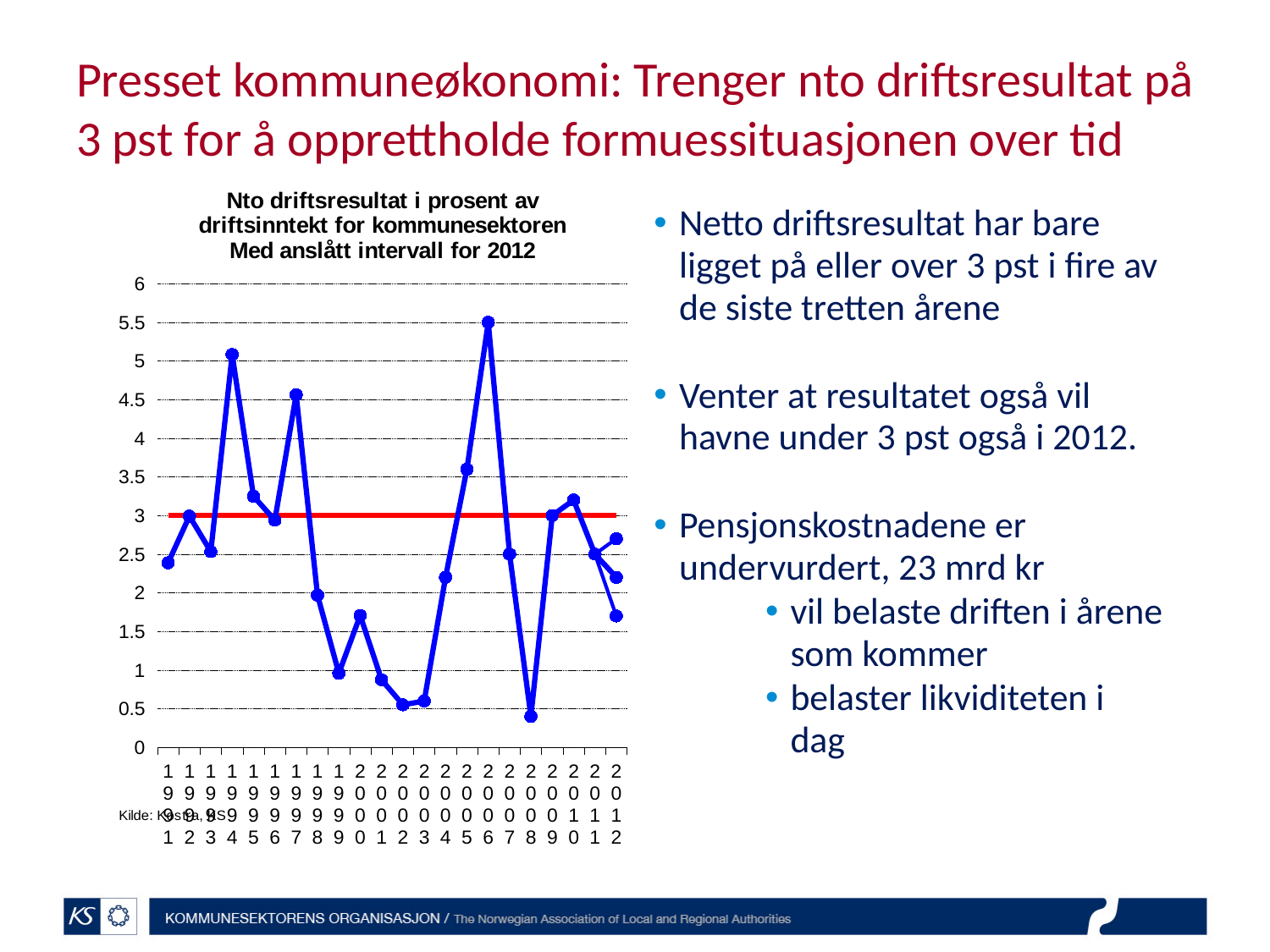
In which year does the net operating result reach its highest value? 2006 What kind of chart is shown on the slide? Line chart In which year does the net operating result reach its lowest value? 2008 Which year has the higher value, 1994 or 1997? 1994 How many years are shown on the x axis of the chart? 22 Is the value for 2002 greater or less than 1? less Do the values rise or fall from 2003 to 2006? Rise Is the value for 2006 greater or less than 5? greater At what level is the horizontal red line drawn on the chart? 3 Is the value for 1997 greater or less than 4? greater